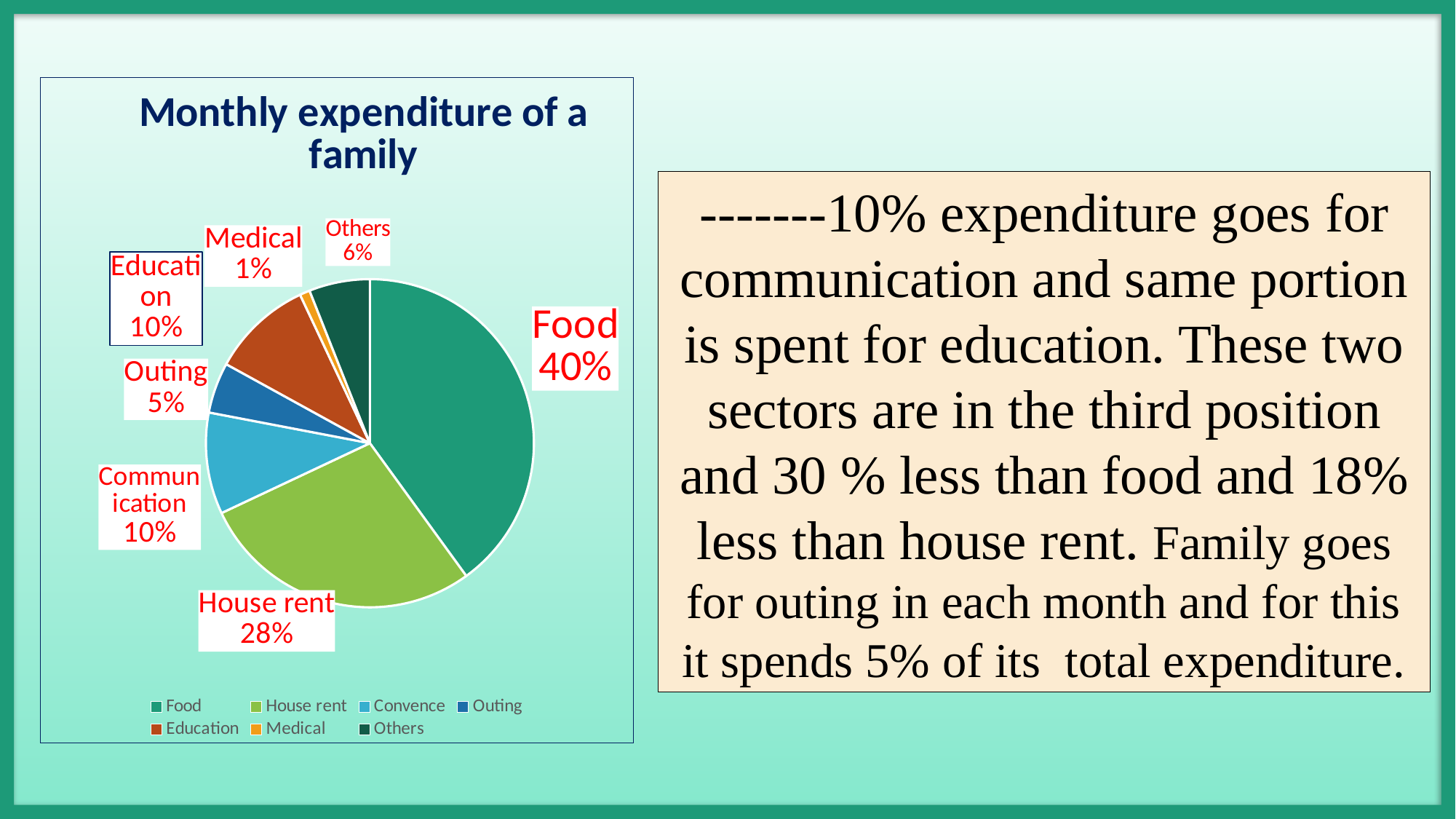
What is the difference between the Food share and the House rent share? 12% What is the title of the chart? Monthly expenditure of a family What percentage of the monthly expenditure goes to Medical? 1% What percentage of the monthly expenditure goes to Others? 6% Which category has the largest share of the monthly expenditure? Food Which is larger, the share for Outing or the share for Others? Others How many slices does the pie chart have? 7 Which category has the smallest share of the monthly expenditure? Medical What kind of chart is shown on the slide? pie chart What percentage of the monthly expenditure goes to House rent? 28% What percentage of the monthly expenditure goes to Food? 40% How many entries does the legend list? 7